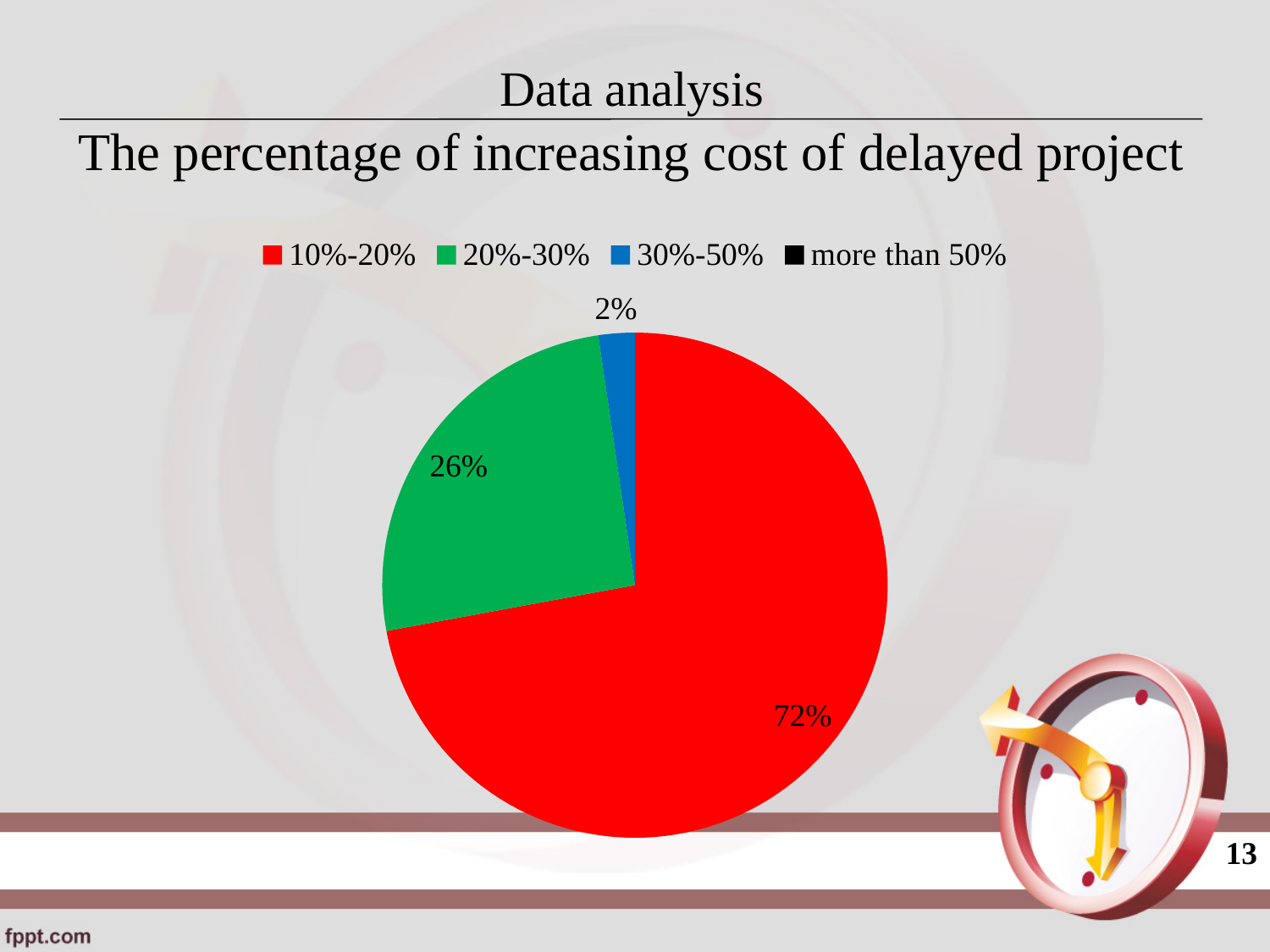
Which of the labelled slices is the smallest? 30%-50% What is the title of the chart? The percentage of increasing cost of delayed project What share of the pie does the 20%-30% category have? 26% What kind of chart is shown on the slide? pie chart How many categories does the legend list? 4 What is the difference between the 10%-20% share and the 20%-30% share? 46% Which category has the largest slice of the pie? 10%-20% Which is larger, the 20%-30% slice or the 30%-50% slice? 20%-30% What is the combined share of the 20%-30% and 30%-50% slices? 28% What share of the pie does the 30%-50% category have? 2% What colour is the slice for the 20%-30% category? green What share of the pie does the 10%-20% category have? 72%